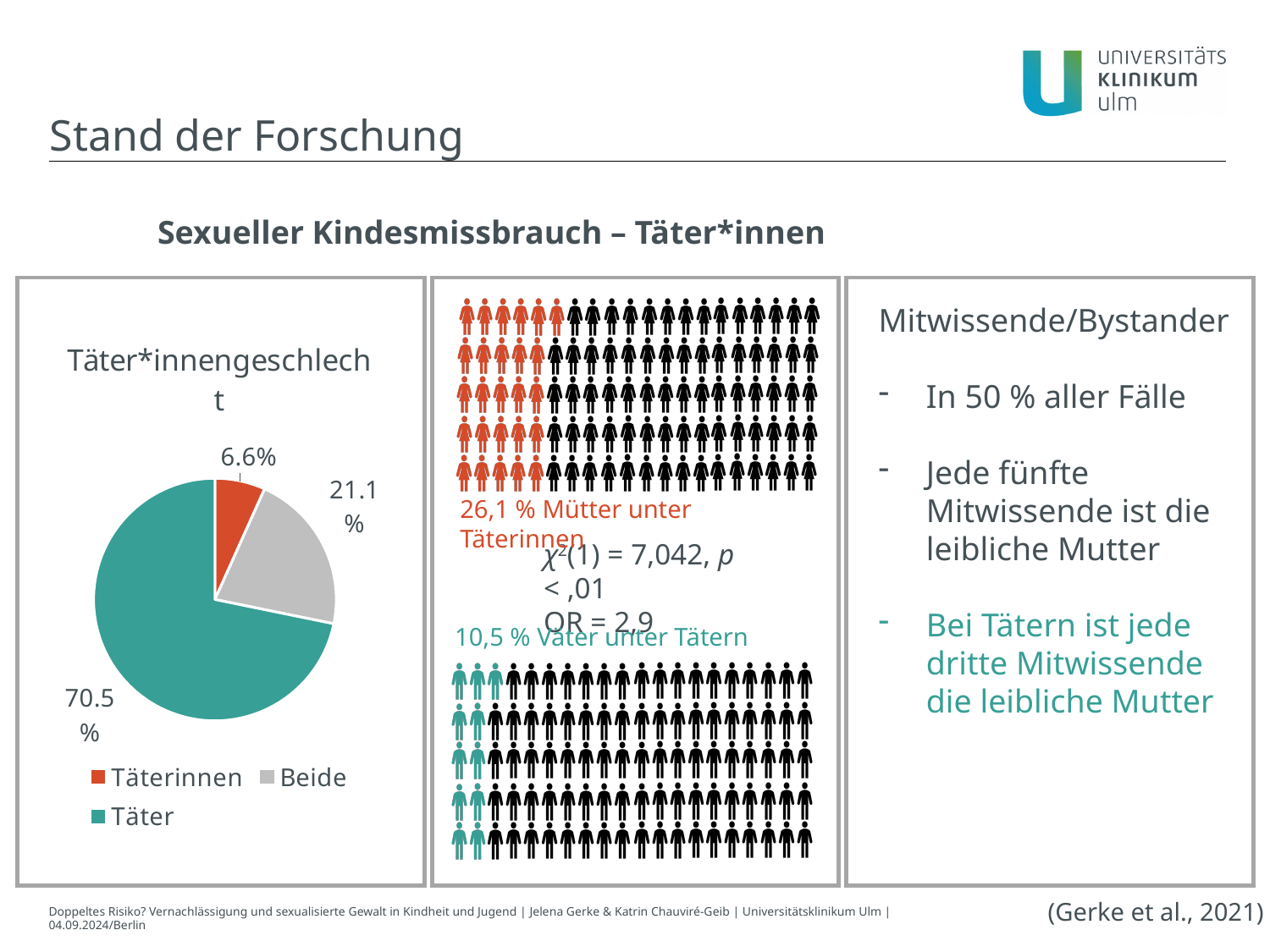
What is the title of the pie chart on the left of the slide? Täter*innengeschlecht In the pie chart 'Täter*innengeschlecht', what colour is the Täterinnen slice? red/orange In the pie chart 'Täter*innengeschlecht', what is the difference between the Beide and Täterinnen percentages? 14.5% What kind of chart is the chart titled 'Täter*innengeschlecht'? pie chart In the pie chart 'Täter*innengeschlecht', which category has the largest slice? Täter In the pie chart 'Täter*innengeschlecht', which category has the smallest slice? Täterinnen In the pie chart 'Täter*innengeschlecht', what percentage is shown for Täterinnen? 6.6% In the pie chart 'Täter*innengeschlecht', what percentage is shown for Beide? 21.1% How many categories does the pie chart 'Täter*innengeschlecht' show? 3 In the pie chart 'Täter*innengeschlecht', what percentage is shown for Täter? 70.5% In the pie chart 'Täter*innengeschlecht', which is larger: Beide or Täterinnen? Beide In the pie chart 'Täter*innengeschlecht', what is the difference between the Täter and Beide percentages? 49.4%